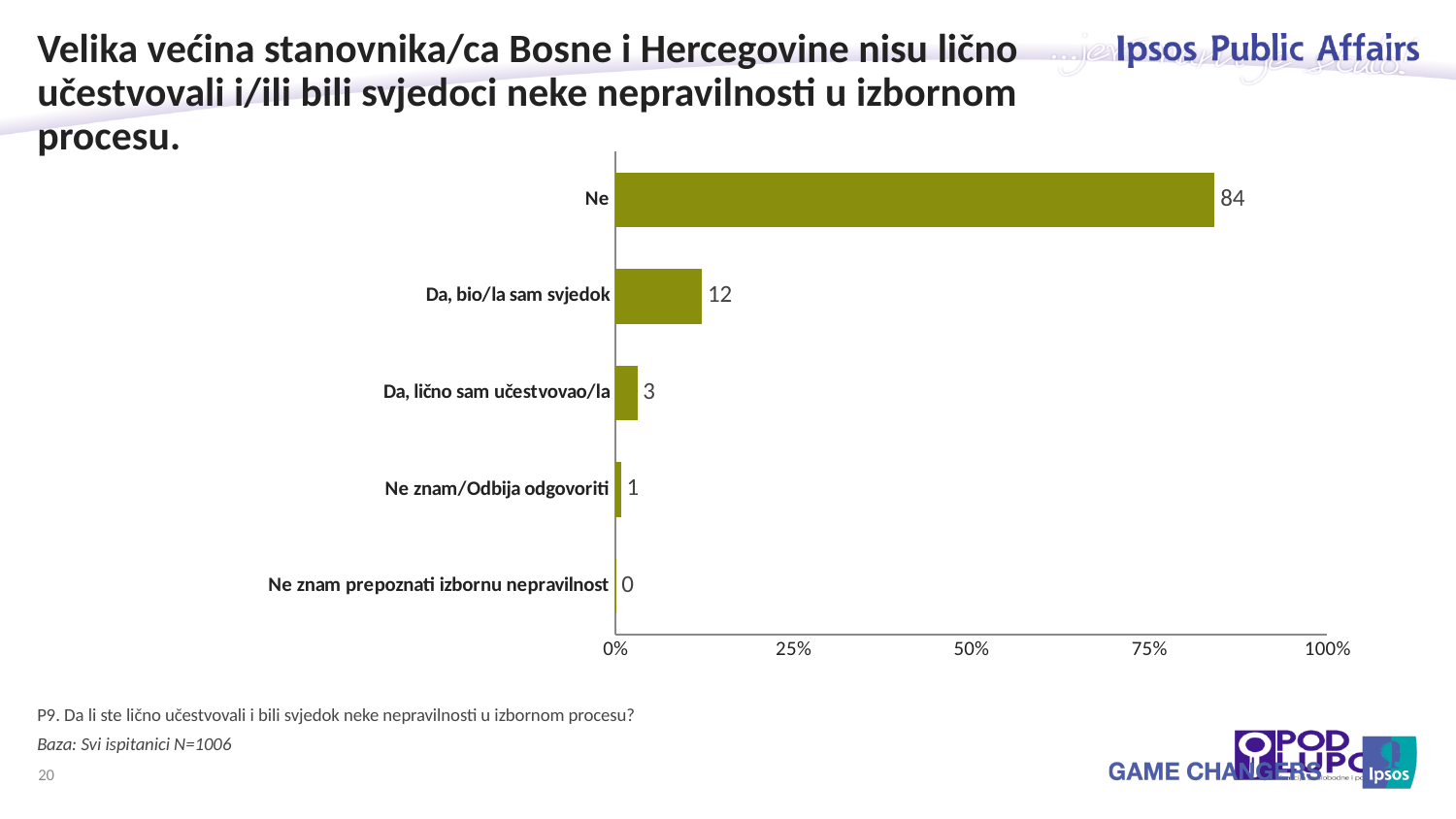
Is the value for "Ne" greater or less than 75%? greater What is the value for "Da, bio/la sam svjedok"? 12 What is the value for "Da, lično sam učestvovao/la"? 3 Which category has the highest value? Ne Which is larger, the value for "Da, bio/la sam svjedok" or the value for "Da, lično sam učestvovao/la"? Da, bio/la sam svjedok How many categories are shown in the chart? 5 What kind of chart is shown on the slide? bar chart What is the value for "Ne znam/Odbija odgovoriti"? 1 What is the value for "Ne znam prepoznati izbornu nepravilnost"? 0 What is the difference between the values for "Ne" and "Da, bio/la sam svjedok"? 72 What is the value for "Ne"? 84 Which category has the lowest value? Ne znam prepoznati izbornu nepravilnost